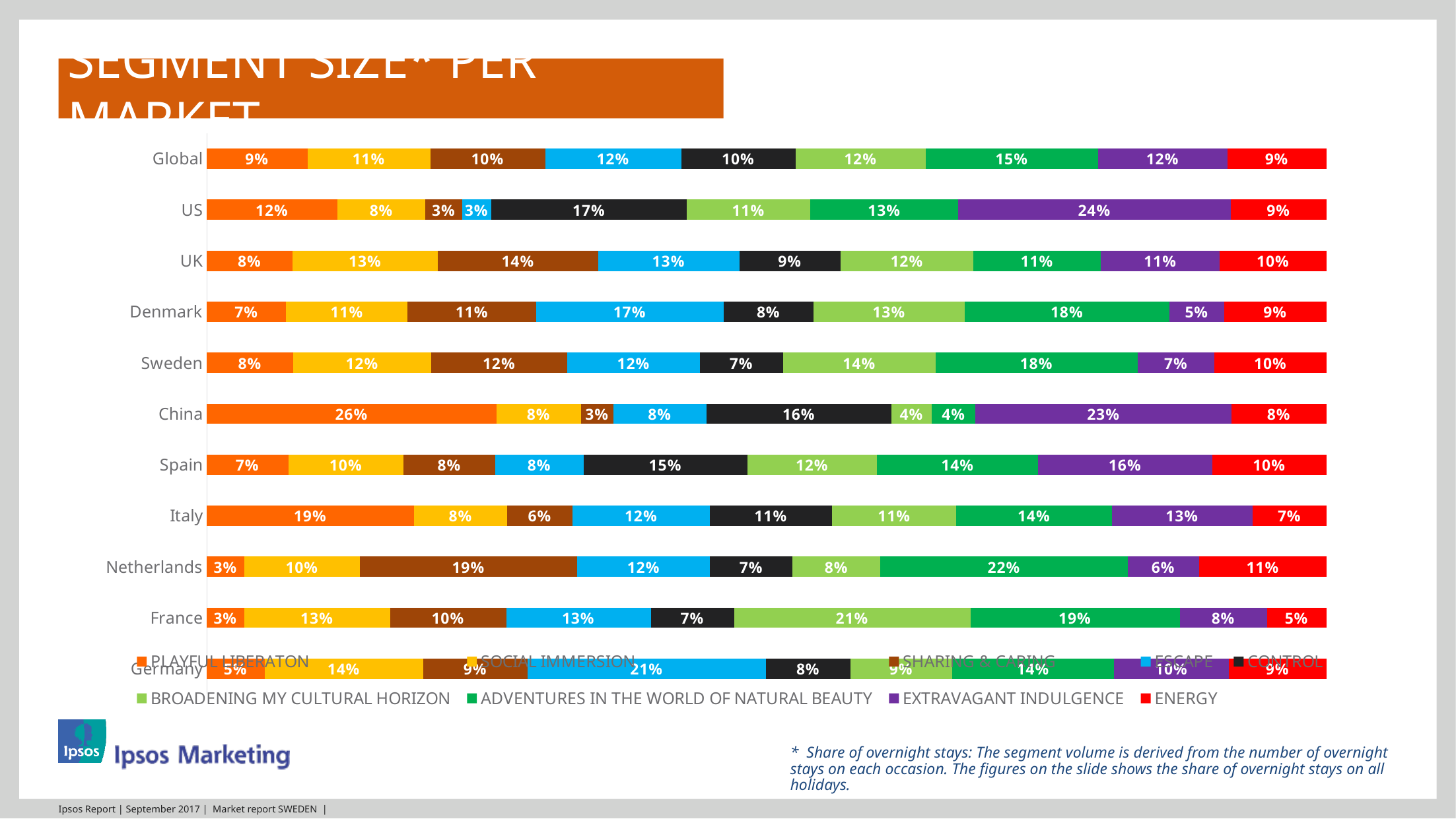
Which has a larger Control value, the US or the UK? US What is the value for Adventures in the World of Natural Beauty in the Netherlands? 22% Which market has the highest value for Playful Liberaton? China What is the difference between the Escape value for Denmark and the Escape value for Sweden? 5 percentage points How many markets are shown on the chart? 11 Which market has the lowest value for Energy? France What is the total of the Global stacked bar? 100% What is the value for Extravagant Indulgence in the US? 24% What is the value for Broadening My Cultural Horizon in France? 21% How many series does the legend list? 9 What kind of chart is shown on the slide? Stacked bar chart What is the value for Playful Liberaton in China? 26%